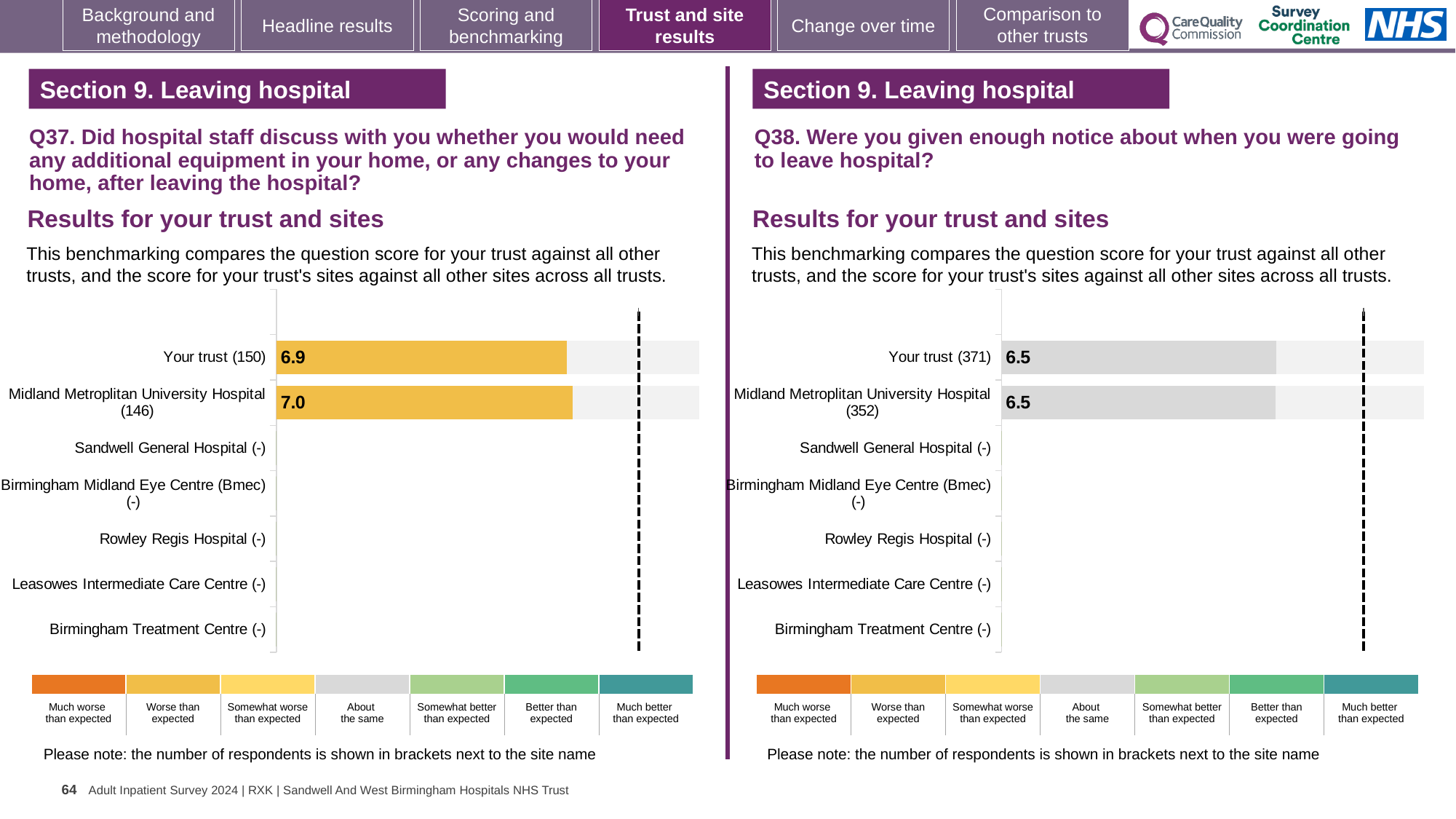
According to the colour key, which benchmark category do the grey bars in the Q38 chart on the right represent? About the same In the Q37 chart on the left, what is the score for Midland Metropolitan University Hospital? 7.0 How many site/trust categories are listed on the y axis of the Q37 chart on the left? 7 In the Q37 chart on the left, what is the difference between the score for Midland Metropolitan University Hospital and the score for Your trust? 0.1 In the Q38 chart on the right, what is the score for Your trust? 6.5 In the Q37 chart on the left, what is the score for Your trust? 6.9 What type of chart is used for the Q38 results on the right? Bar chart In the Q38 chart on the right, how many respondents are shown in brackets for Midland Metropolitan University Hospital? 352 In the Q38 chart on the right, what is the difference between the score for Your trust and the score for Midland Metropolitan University Hospital? 0.0 In the Q37 chart on the left, how many respondents are shown in brackets for Your trust? 150 In the Q38 chart on the right, what is the score for Midland Metropolitan University Hospital? 6.5 In the Q37 chart on the left, which has the higher score: Your trust or Midland Metropolitan University Hospital? Midland Metropolitan University Hospital